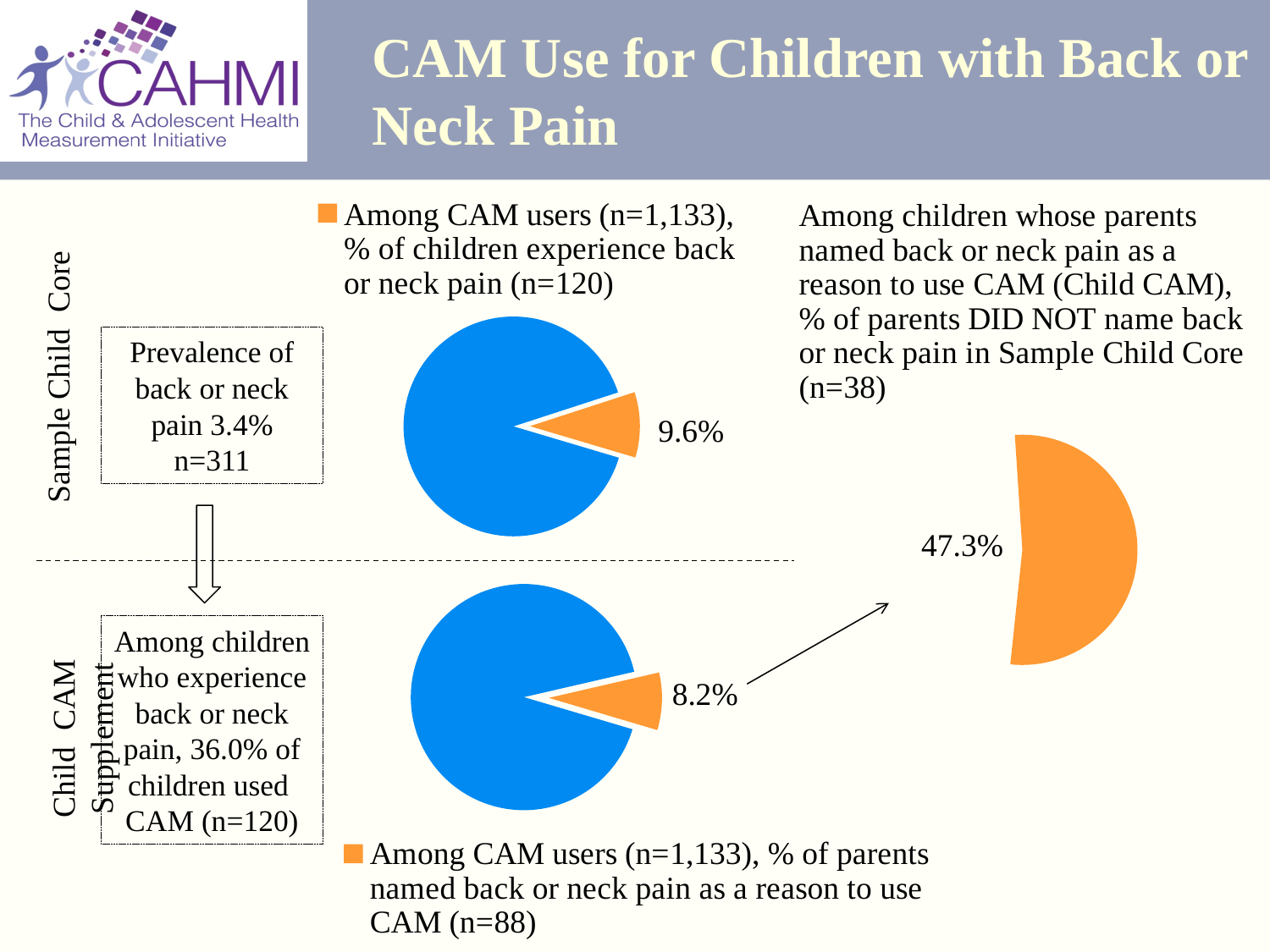
How many pie charts are shown on the slide? 3 What is the difference between the 9.6% in the top pie chart and the 8.2% in the bottom pie chart? 1.4 percentage points What kind of chart is the top chart in the middle of the slide? Pie chart In the pie chart on the right of the slide (parents who did not name back or neck pain in Sample Child Core), what percentage is labelled? 47.3% What is the difference between the 47.3% in the right-hand pie chart and the 8.2% in the bottom pie chart? 39.1 percentage points In the bottom pie chart (among CAM users, % of parents who named back or neck pain as a reason to use CAM), what percentage is shown for the orange slice? 8.2% What colour is the highlighted slice in the top pie chart? Orange What is the sample size (n) given in the legend for the bottom pie chart's orange slice? n=88 In the top pie chart (among CAM users, % of children who experience back or neck pain), what percentage is shown for the orange slice? 9.6% Which is larger: the orange slice in the top pie chart (9.6%) or the orange slice in the bottom pie chart (8.2%)? The top pie chart (9.6%) Which is larger: the 47.3% in the right-hand pie chart or the 8.2% in the bottom pie chart? The right-hand pie chart (47.3%)